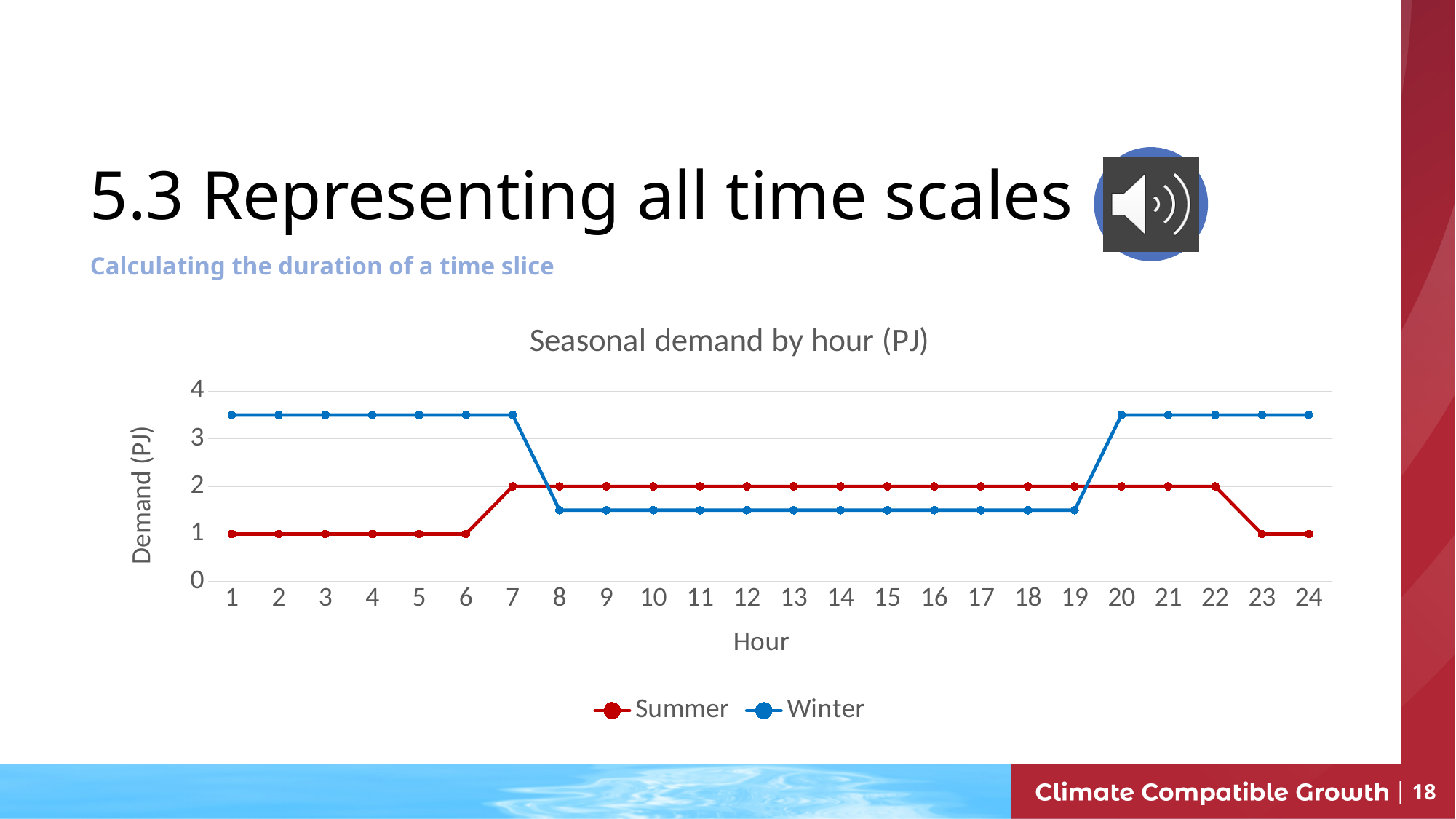
What is the title of the chart? Seasonal demand by hour (PJ) How many series does the legend list? 2 What is the Summer demand at hour 3? 1 What is the Summer demand at hour 12? 2 At hour 5, which series has the higher demand, Summer or Winter? Winter How many hours are plotted along the x axis? 24 Is the Winter demand at hour 12 greater or less than 2? less Is the Winter demand at hour 2 greater or less than 3? greater What kind of chart is shown on the slide? line chart At hour 15, which series has the higher demand, Summer or Winter? Summer Does the Summer demand rise or fall between hour 6 and hour 7? rise What is the Summer demand at hour 24? 1